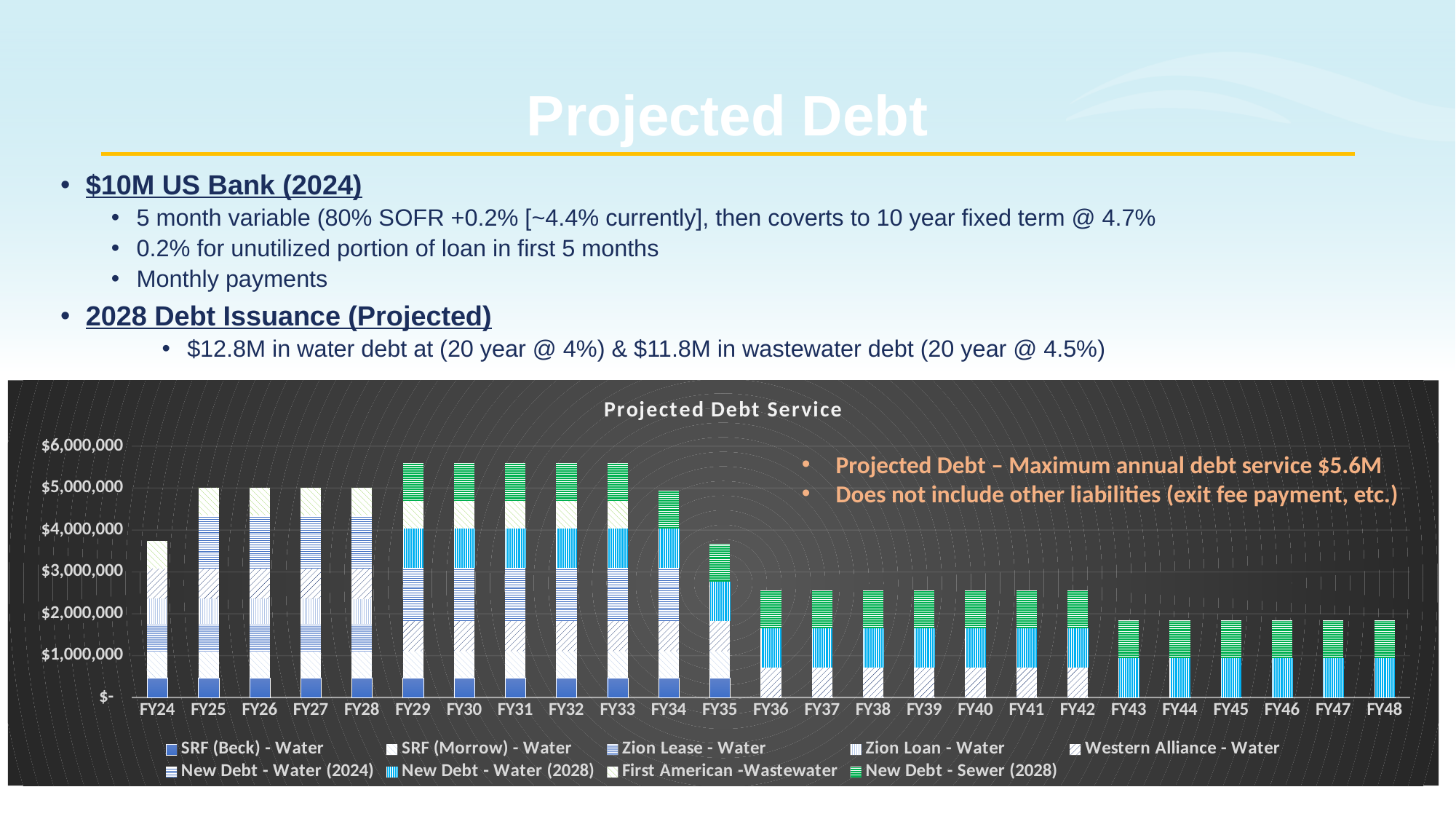
Is the total debt service for FY36 greater or less than $2,000,000? greater Which fiscal year has the larger total debt service, FY34 or FY35? FY34 Is the total debt service for FY24 greater or less than $4,000,000? less What kind of chart is shown on the slide? Stacked bar chart Which fiscal year has the larger total debt service, FY24 or FY25? FY25 Is the total debt service for FY24 greater or less than $3,000,000? greater From FY33 to FY48, do the total debt service bars generally rise or fall? fall How many fiscal years are shown on the x axis of the chart? 25 What is the title of the chart? Projected Debt Service How many series does the chart legend list? 9